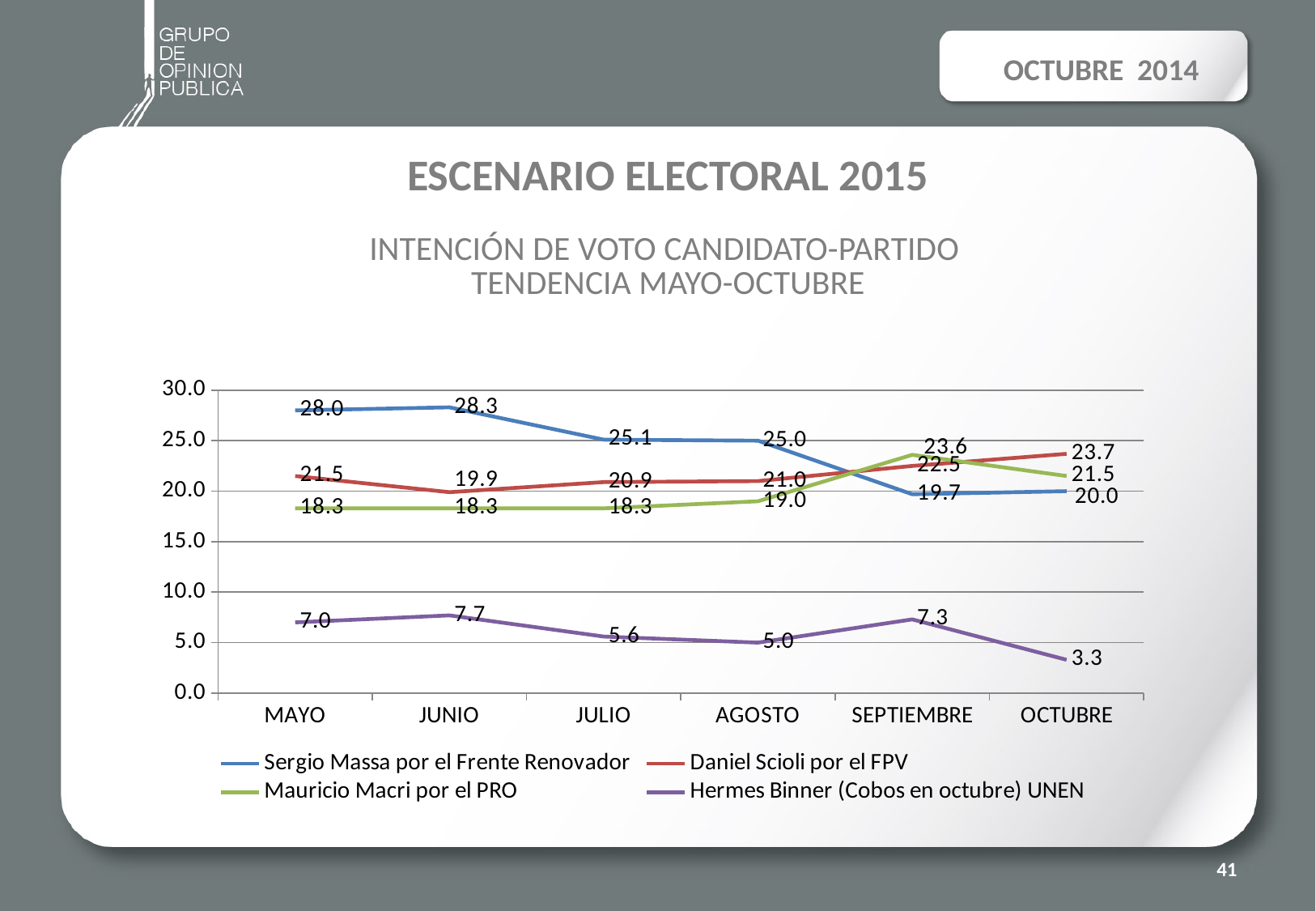
What type of chart is shown on the slide? line chart How many series does the legend list? 4 What is the difference between Sergio Massa's value in MAYO and in OCTUBRE? 8.0 Does the line for Sergio Massa por el Frente Renovador generally rise or fall from MAYO to OCTUBRE? fall What is the title of the chart? ESCENARIO ELECTORAL 2015 In which month is the value for Hermes Binner (Cobos en octubre) UNEN lowest? OCTUBRE In OCTUBRE, which is higher: Daniel Scioli por el FPV or Sergio Massa por el Frente Renovador? Daniel Scioli por el FPV What is the value for Daniel Scioli por el FPV in OCTUBRE? 23.7 How many months are shown on the x axis? 6 What is the value for Sergio Massa por el Frente Renovador in JUNIO? 28.3 What is the value for Hermes Binner (Cobos en octubre) UNEN in AGOSTO? 5.0 In which month does Mauricio Macri por el PRO reach its highest value? SEPTIEMBRE